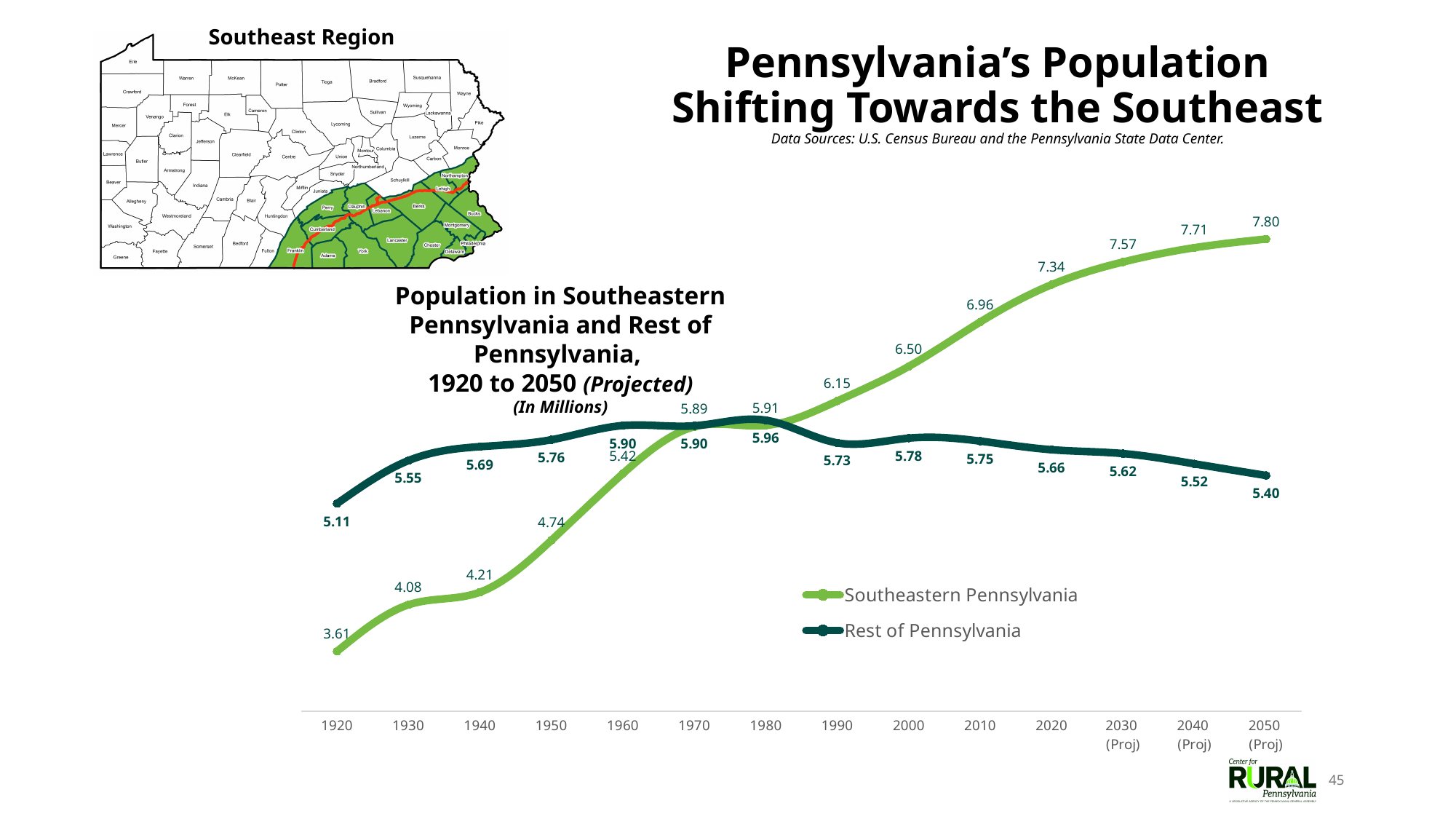
What is the difference between the projected 2050 populations of Southeastern Pennsylvania and the Rest of Pennsylvania? 2.40 How many years are plotted along the x axis of the chart? 14 In which year does the Rest of Pennsylvania series reach its highest value? 1980 What is the projected population of the Rest of Pennsylvania in 2040? 5.52 In which year is the Southeastern Pennsylvania population at its lowest? 1920 In 1920, which had the larger population: Southeastern Pennsylvania or the Rest of Pennsylvania? Rest of Pennsylvania What kind of chart is shown on the slide? Line chart In what units are the population values on the chart expressed? In Millions What is the projected population of Southeastern Pennsylvania in 2050? 7.80 What was the population of the Rest of Pennsylvania in 1920? 5.11 How many series does the chart's legend list? 2 Does the Southeastern Pennsylvania population rise or fall from 1920 to 2050? Rise